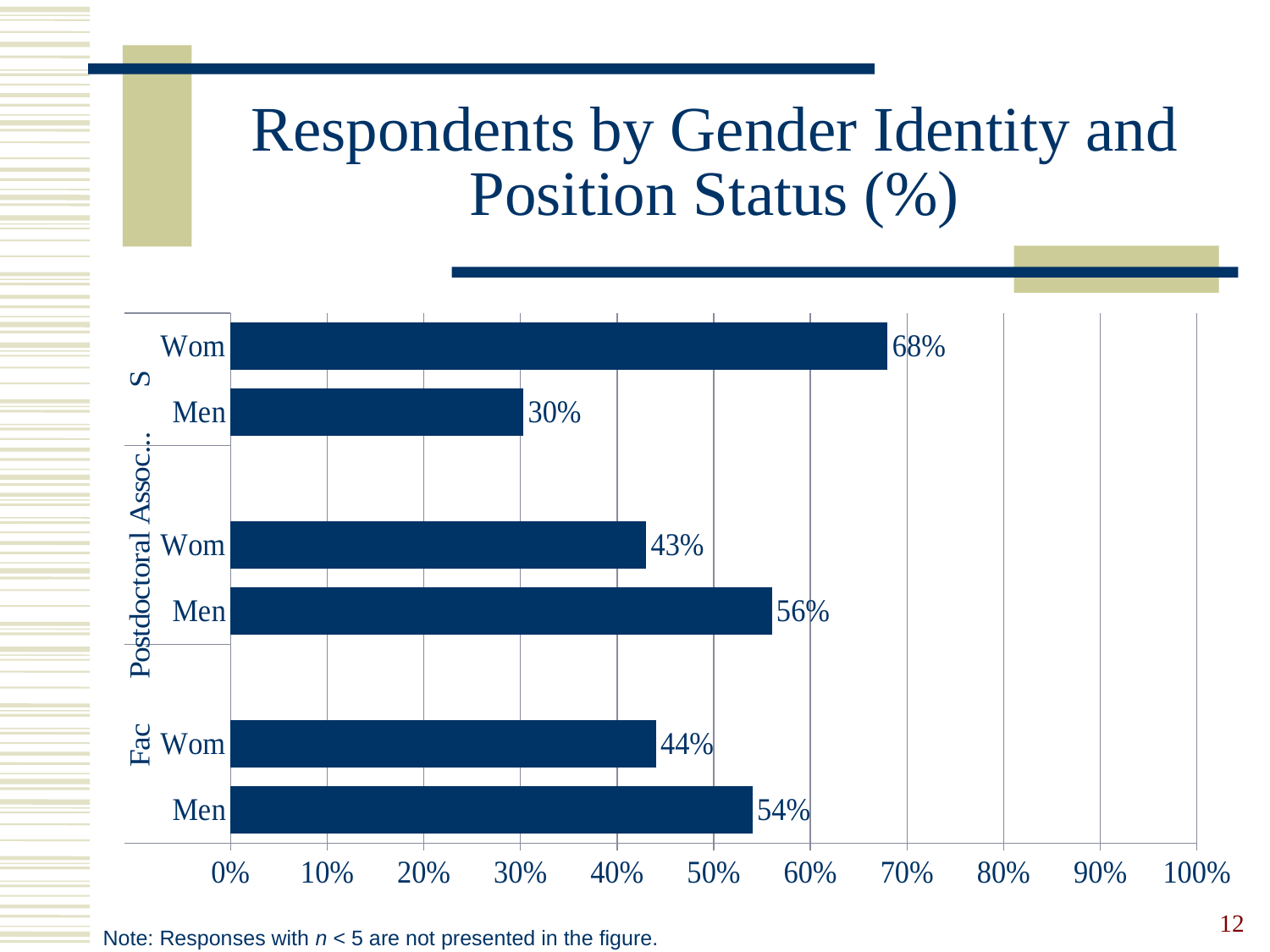
What is the value for Wom in the group labelled "Postdoctoral Assoc..."? 43% What is the value for Men in the group labelled "S"? 30% How many bars are plotted in the chart? 6 What type of chart is shown on the slide? bar chart Which bar has the highest value in the chart? Wom in the "S" group (68%) What is the value for Men in the group labelled "Fac"? 54% What is the value for Wom in the group labelled "S"? 68% In the group labelled "Fac", which is larger, the value for Wom or for Men? Men What is the title of the chart on the slide? Respondents by Gender Identity and Position Status (%) Which bar has the lowest value in the chart? Men in the "S" group (30%) Is the value for Men in the group labelled "Postdoctoral Assoc..." greater or less than 50%? greater What is the difference between the Wom and Men values in the group labelled "S"? 38%